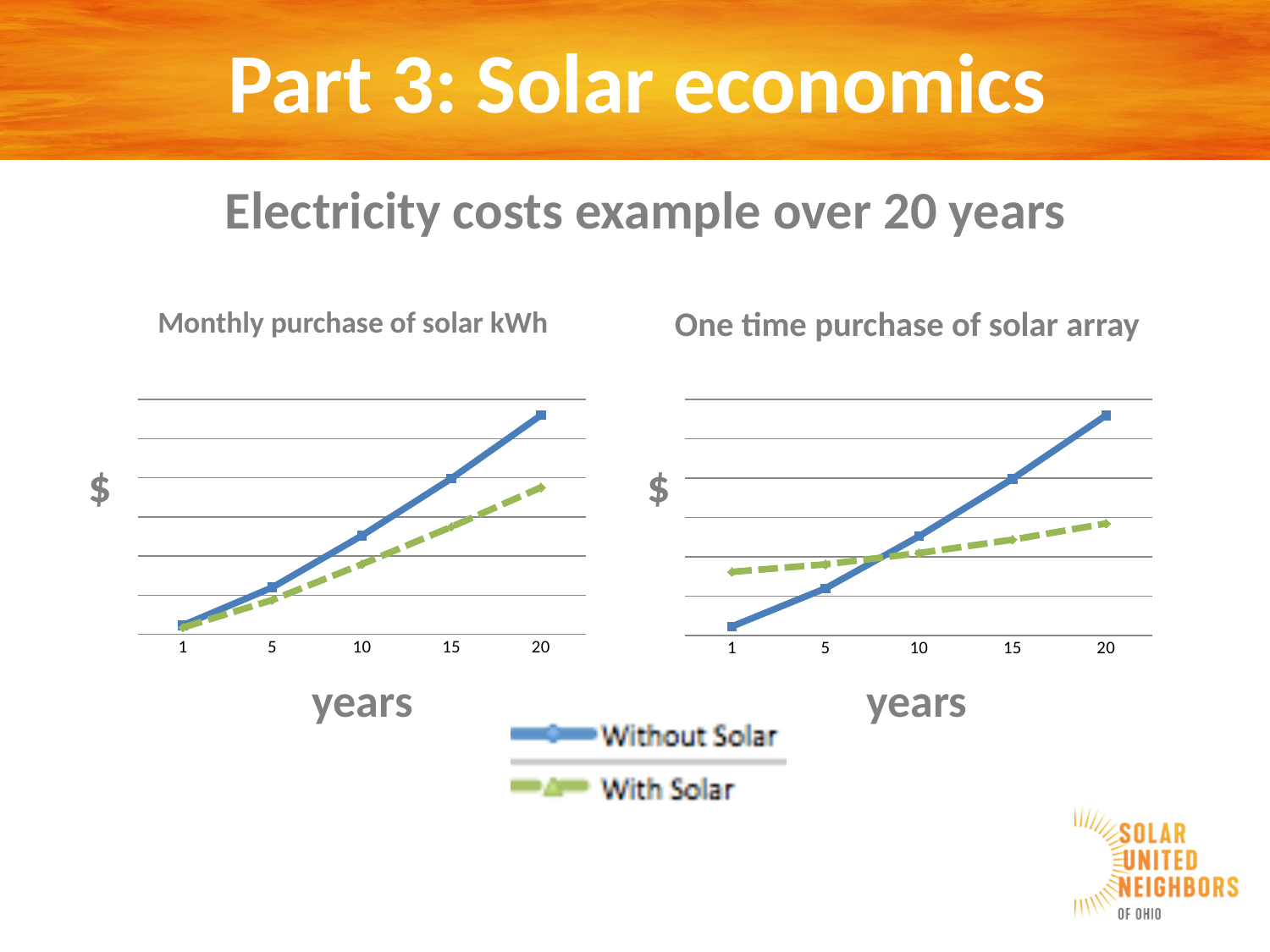
In the "One time purchase of solar array" chart, does the With Solar line rise or fall from year 1 to year 20? rise How many series does the legend list for the charts? 2 In the "One time purchase of solar array" chart, which series is higher at year 1, Without Solar or With Solar? With Solar What kind of chart is the "One time purchase of solar array" chart? line chart How many points are plotted along the x axis in the "Monthly purchase of solar kWh" chart? 5 What label is shown on the x axis of both charts? years In the "Monthly purchase of solar kWh" chart, does the Without Solar line rise or fall from year 1 to year 20? rise In the "Monthly purchase of solar kWh" chart, which series is higher at year 20, Without Solar or With Solar? Without Solar Which series is drawn with a dashed green line in the legend? With Solar What kind of chart is the "Monthly purchase of solar kWh" chart? line chart In the "One time purchase of solar array" chart, which series is higher at year 20, Without Solar or With Solar? Without Solar In the "One time purchase of solar array" chart, at which year does the Without Solar series reach its highest value? 20